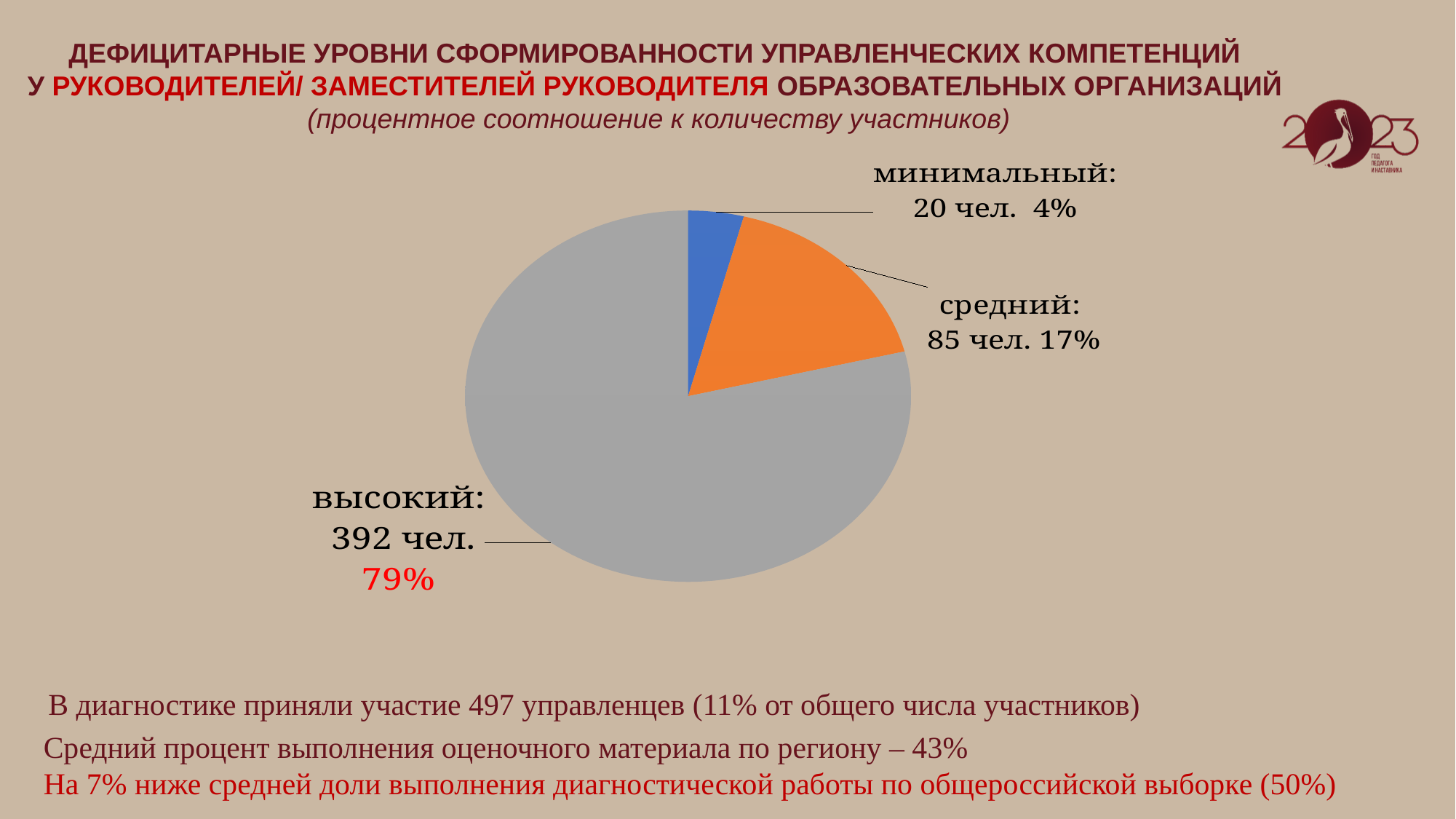
Какой тип диаграммы показан на слайде? круговая диаграмма Сколько человек относится к уровню «высокий»? 392 чел. Какая группа больше: «средний» или «минимальный»? средний Какой уровень занимает наибольшую долю диаграммы? высокий На сколько человек больше в группе «средний», чем в группе «минимальный»? 65 Каким цветом показан сектор «высокий»? серым На сколько процентных пунктов доля уровня «высокий» больше доли уровня «средний»? 62 Какой процент участников имеет уровень «минимальный»? 4% Сколько человек относится к уровню «минимальный»? 20 чел. Какой уровень занимает наименьшую долю диаграммы? минимальный Какой процент участников имеет уровень «средний»? 17% Сколько секторов (категорий) на круговой диаграмме? 3